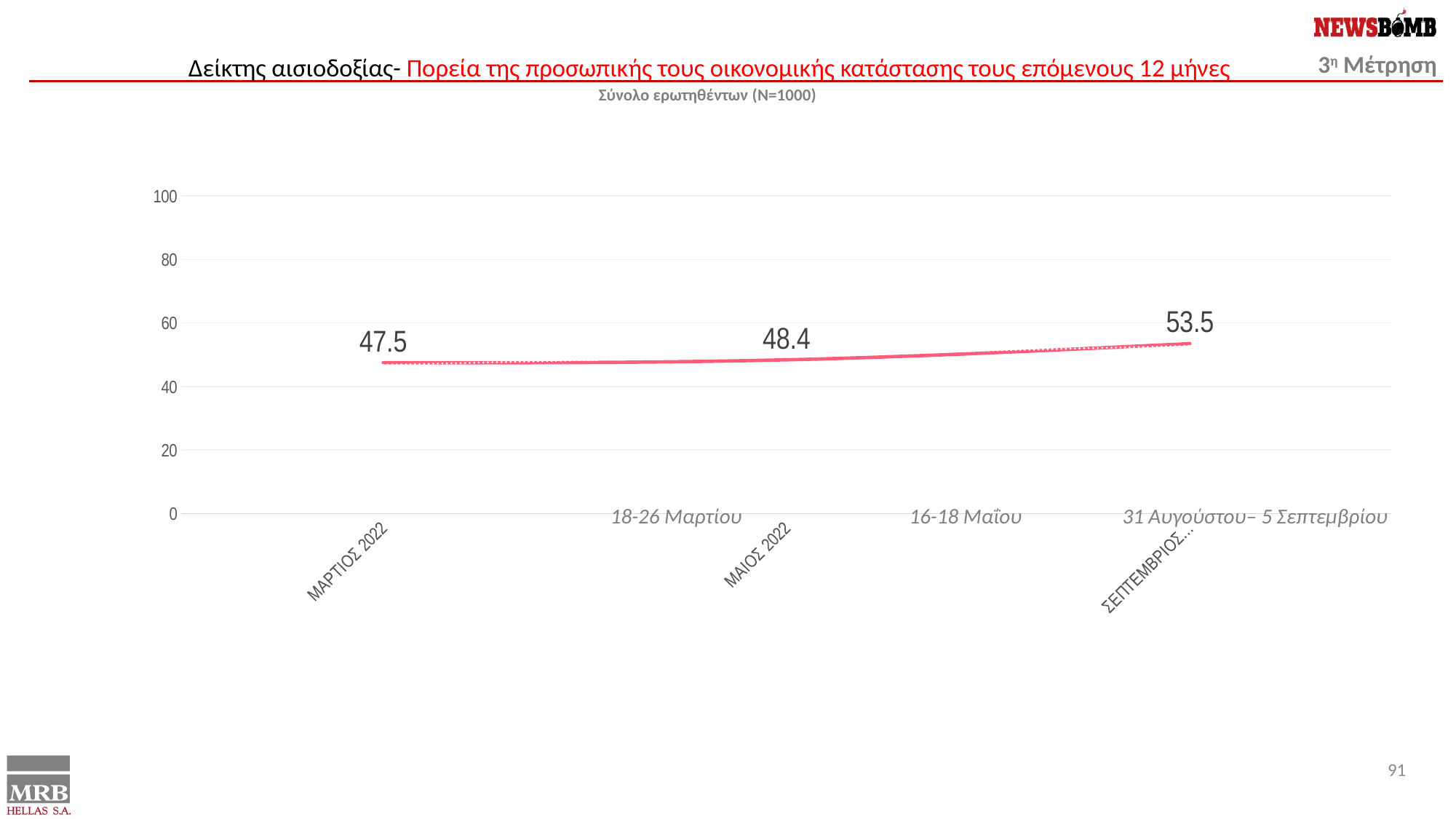
What is the difference between the September 2022 value and the ΜΑΡΤΙΟΣ 2022 value? 6.0 What is the difference between the ΜΑΪΟΣ 2022 value and the ΜΑΡΤΙΟΣ 2022 value? 0.9 Which measurement period has the lowest value? ΜΑΡΤΙΟΣ 2022 How many measurement points are plotted on the chart? 3 What is the value for ΜΑΡΤΙΟΣ 2022? 47.5 What kind of chart is shown on the slide? line chart Is the value for ΜΑΡΤΙΟΣ 2022 greater or less than 60? less Which measurement period has the highest value? ΣΕΠΤΕΜΒΡΙΟΣ 2022 What is the value for ΜΑΪΟΣ 2022? 48.4 Which is larger, the value for ΜΑΪΟΣ 2022 or the value for September 2022? September 2022 Do the values rise or fall from ΜΑΡΤΙΟΣ 2022 to September 2022? rise What is the value for the September 2022 measurement (ΣΕΠΤΕΜΒΡΙΟΣ)? 53.5